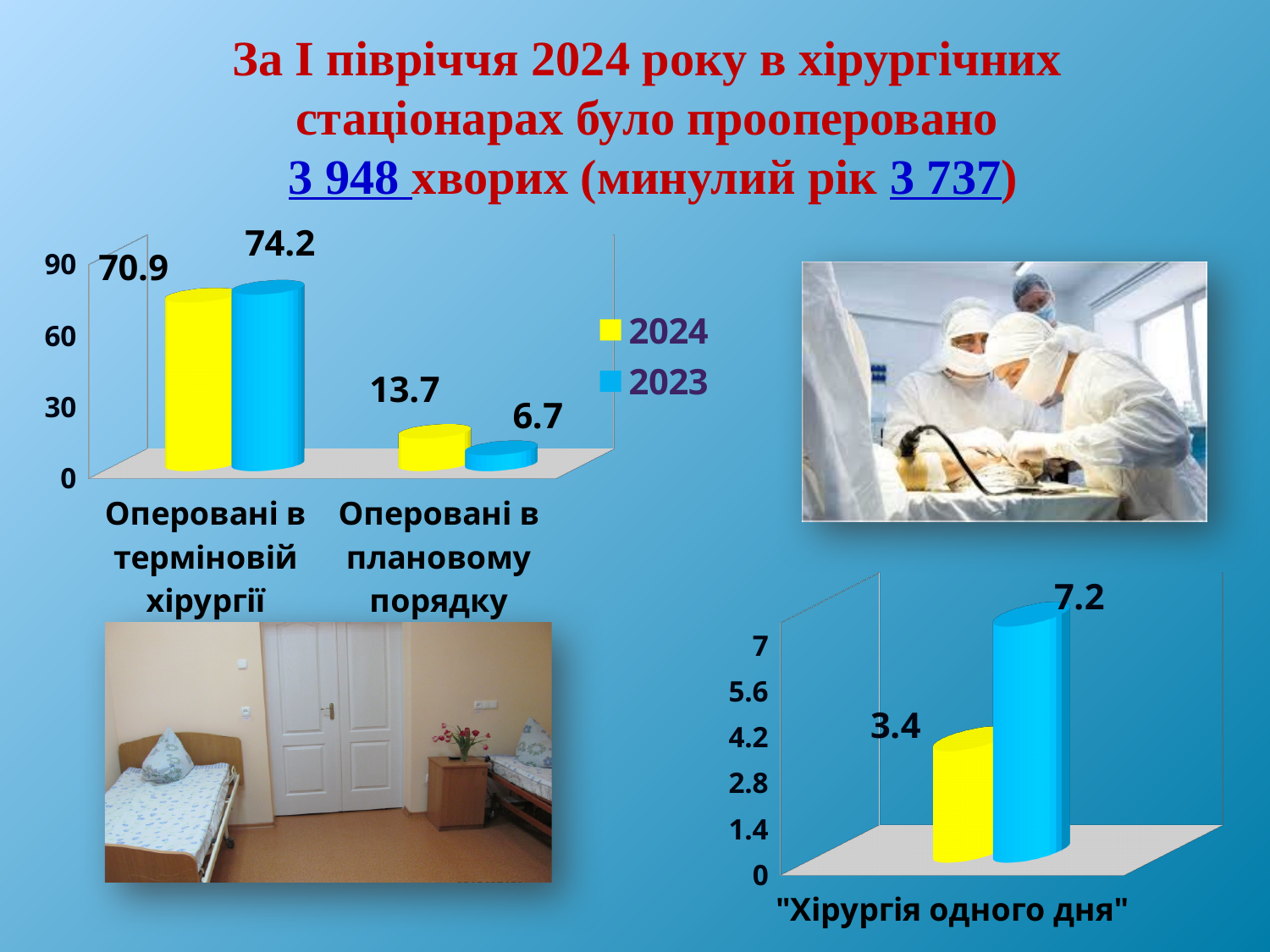
In the chart titled "Хірургія одного дня", what is the value of the blue bar? 7.2 In the left chart, what is the 2024 value for "Оперовані в терміновій хірургії"? 70.9 In the left chart, what is the 2024 value for "Оперовані в плановому порядку"? 13.7 In the left chart, what is the 2023 value for "Оперовані в терміновій хірургії"? 74.2 How many series does the legend of the left chart list? 2 In the chart titled "Хірургія одного дня", what is the value of the yellow bar? 3.4 In the chart titled "Хірургія одного дня", what is the difference between the blue bar and the yellow bar? 3.8 How many categories are shown on the x axis of the left chart? 2 In the left chart, what is the 2023 value for "Оперовані в плановому порядку"? 6.7 What type of chart is the left chart? Bar chart In the left chart, which year has the larger value for "Оперовані в плановому порядку", 2024 or 2023? 2024 In the left chart, what is the difference between the 2023 and 2024 values for "Оперовані в терміновій хірургії"? 3.3